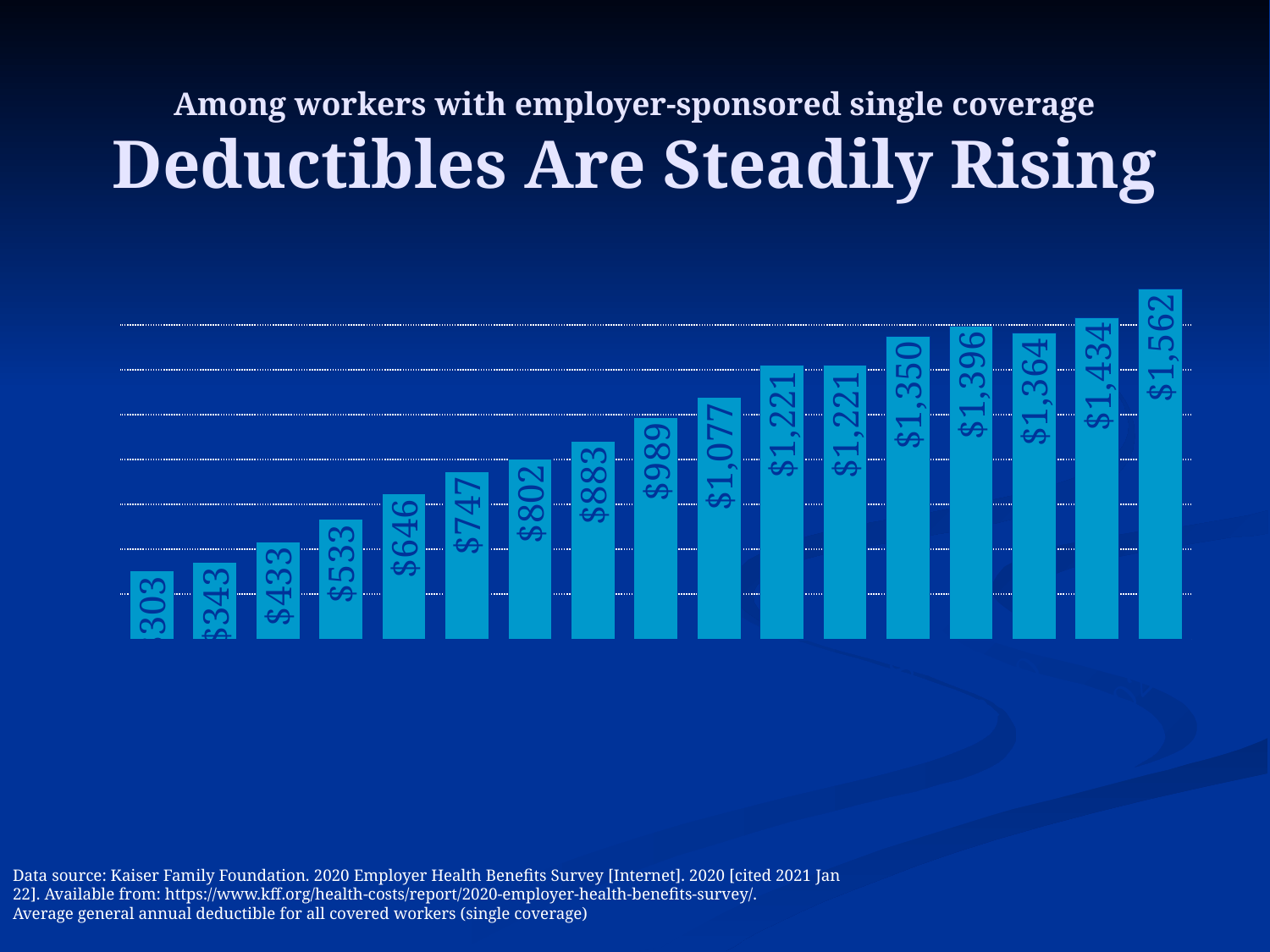
How many bars are plotted in the chart? 17 What is the value of the tallest (rightmost) bar in the chart? $1,562 What is the difference between the rightmost bar ($1,562) and the bar immediately to its left ($1,434)? $128 Which is larger: the bar labeled $1,396 or the bar labeled $1,364? $1,396 Do the values generally rise or fall from left to right across the chart? rise What is the value of the second bar from the left? $343 What is the main title of the chart on the slide? Deductibles Are Steadily Rising Which bar has the lowest value in the chart? the first (leftmost) bar How many bars have a value above $1,000? 8 What is the value of the second bar from the right? $1,434 What kind of chart is shown on the slide? bar chart What is the value of the fifth bar from the left? $646